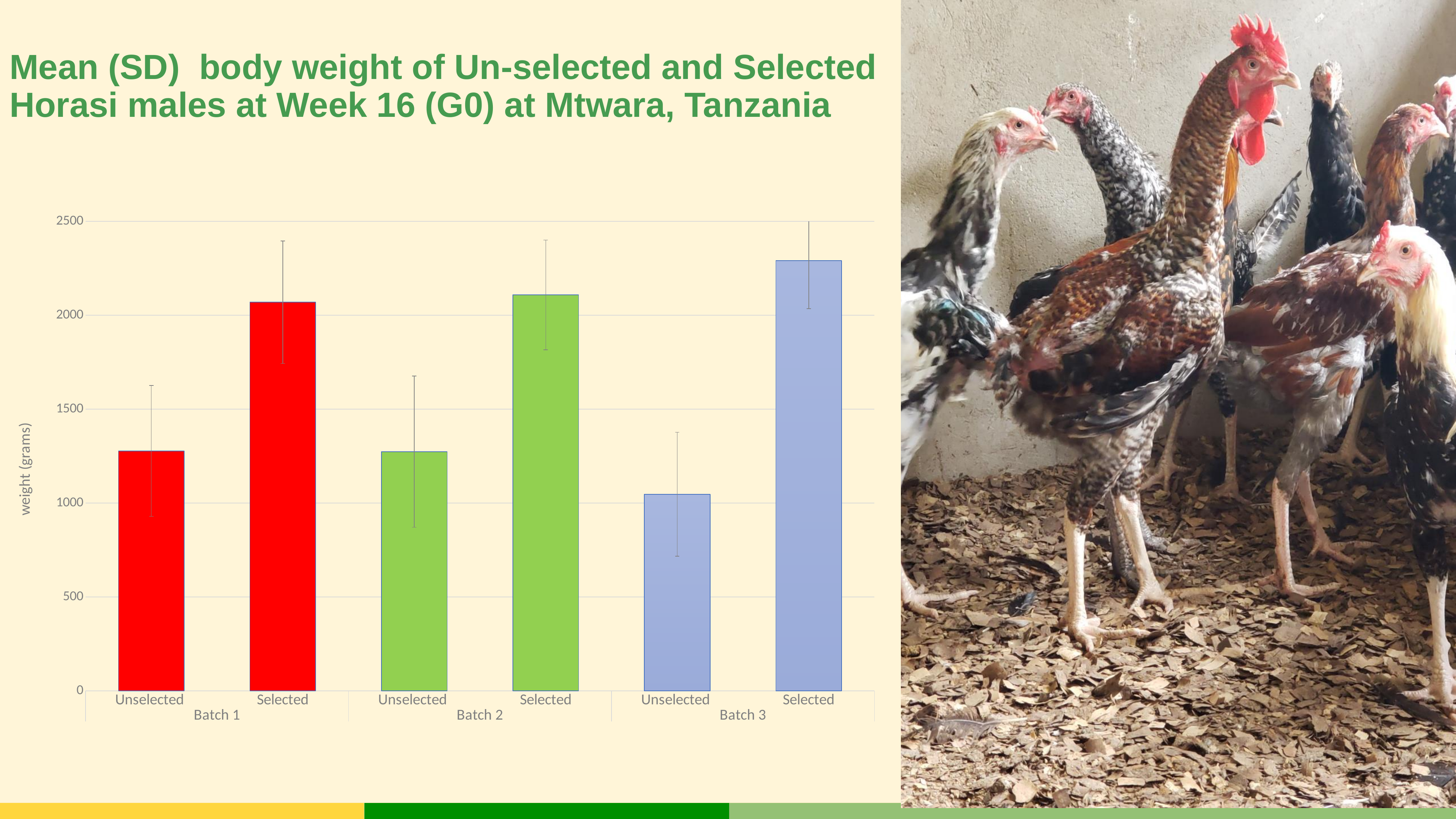
Is the value for Batch 1 Selected greater or less than 2000? greater How many bars are plotted in the chart? 6 In Batch 1, which is larger: the Unselected or the Selected bar? Selected Which bar is the lowest in the chart? Batch 3 Unselected Which is larger: the Selected bar for Batch 2 or the Selected bar for Batch 3? Batch 3 Selected What kind of chart is shown on the slide? bar chart How many batches are shown on the x axis of the chart? 3 Is the value for Batch 2 Unselected greater or less than 1000? greater Which bar is the highest in the chart? Batch 3 Selected What colour are the bars for Batch 2? green What is the label on the y axis of the chart? weight (grams) Is the value for Batch 3 Unselected greater or less than 1500? less